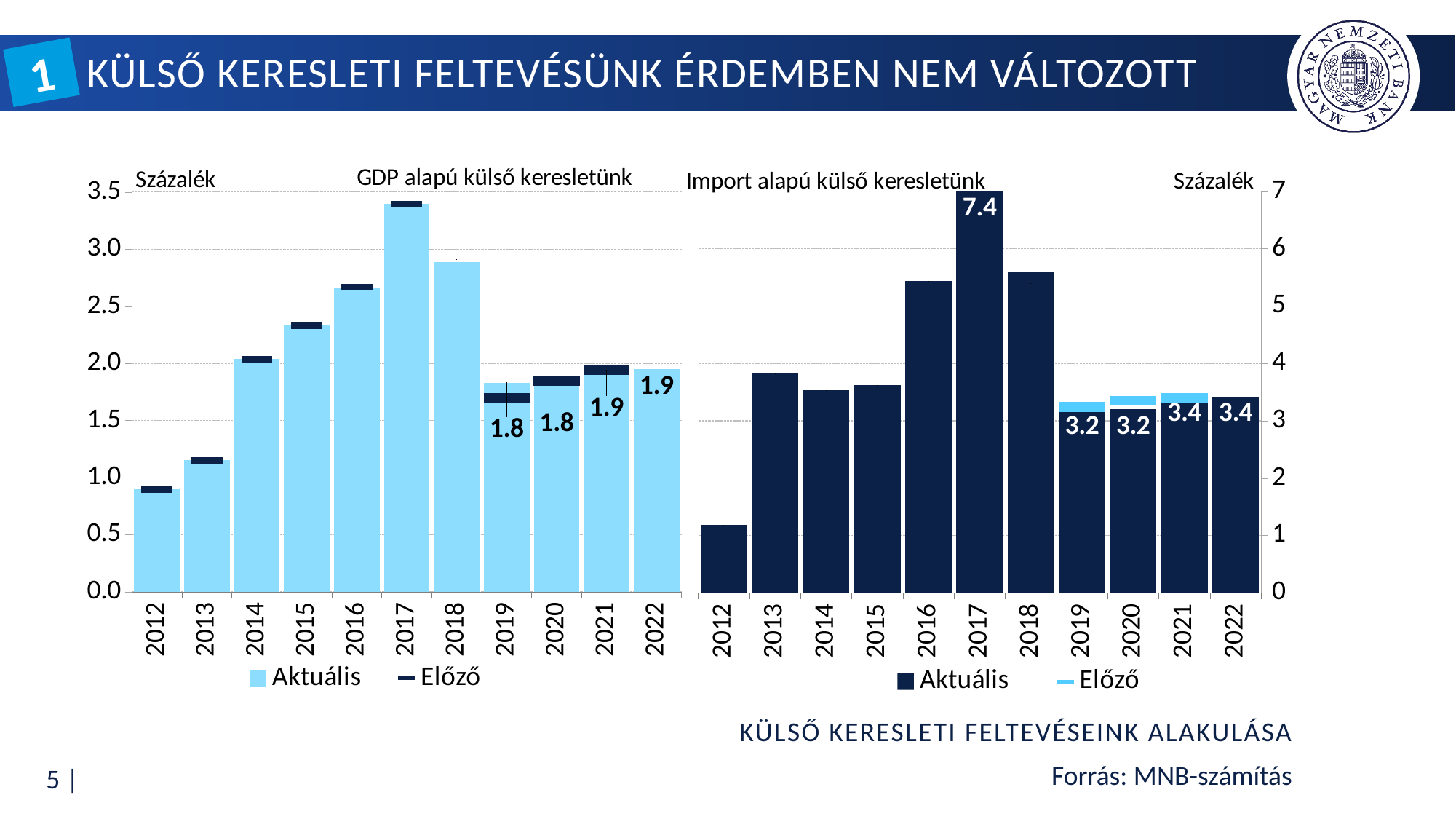
In the 'Import alapú külső keresletünk' chart, what is the difference between the Aktuális values for 2017 and 2019? 4.2 What type of chart is the 'GDP alapú külső keresletünk' chart? Bar chart In the 'Import alapú külső keresletünk' chart, what is the Aktuális value for 2020? 3.2 In the 'GDP alapú külső keresletünk' chart, what is the Aktuális value for 2022? 1.9 In the 'Import alapú külső keresletünk' chart, is the Aktuális value for 2013 greater or less than 4? less In the 'GDP alapú külső keresletünk' chart, which year has the larger Aktuális bar, 2016 or 2018? 2018 In the 'Import alapú külső keresletünk' chart, which year has the lowest Aktuális bar? 2012 In the 'GDP alapú külső keresletünk' chart, which year has the highest Aktuális bar? 2017 In the 'GDP alapú külső keresletünk' chart, is the Aktuális value for 2018 greater or less than 2.5? greater In the 'Import alapú külső keresletünk' chart, what is the Aktuális value for 2017? 7.4 How many series does the legend of the 'Import alapú külső keresletünk' chart list? 2 How many years are shown on the x axis of the 'GDP alapú külső keresletünk' chart? 11